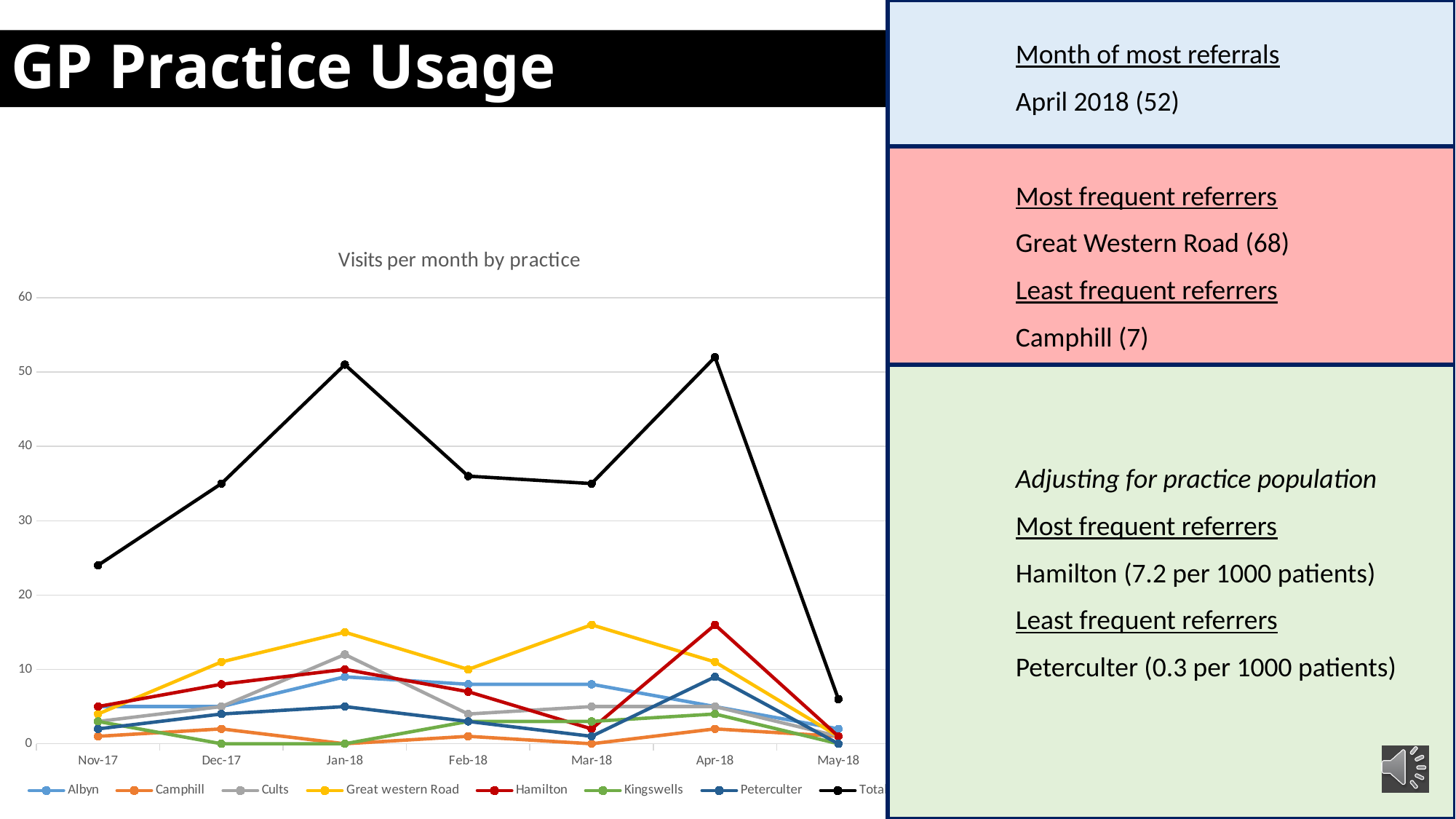
Is the value for Total in Nov-17 greater or less than 30? less In which month is the Total series at its lowest? May-18 What is the title of the chart? Visits per month by practice What is the value for Great western Road in Feb-18? 10 Does the Total series rise or fall from Apr-18 to May-18? fall Is the value for Total in May-18 greater or less than 10? less How many series does the chart legend list? 8 Is the value for Total in Feb-18 greater or less than 30? greater Which is larger in Mar-18, the value for Great western Road or the value for Camphill? Great western Road How many months are plotted along the x axis of the chart? 7 What kind of chart is shown on the slide? line chart What is the value for Kingswells in Jan-18? 0